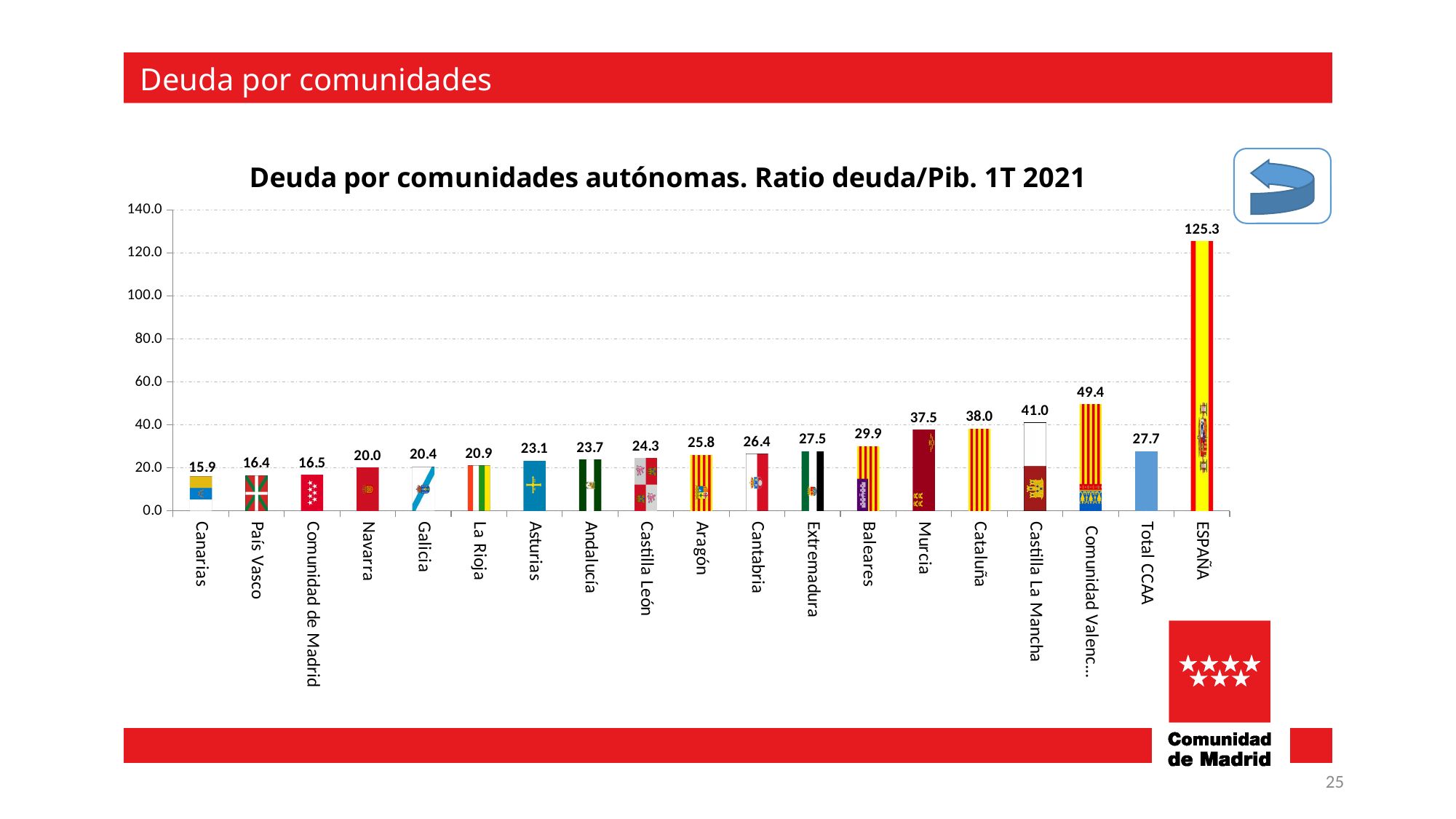
What is the difference between the values for Castilla La Mancha and Murcia? 3.5 Which category has the lowest value in the chart? Canarias Which category has the highest value in the chart? ESPAÑA Is the value for ESPAÑA greater or less than 120.0? greater What value is shown for Total CCAA? 27.7 Which has a higher value, Baleares or Extremadura? Baleares What value is shown for Cataluña? 38.0 What type of chart is shown on the slide? Bar chart What is the difference between the values for ESPAÑA and Comunidad de Madrid? 108.8 How many bars are plotted in the chart? 19 What is the debt/GDP ratio shown for Comunidad de Madrid? 16.5 What is the title of the chart? Deuda por comunidades autónomas. Ratio deuda/Pib. 1T 2021